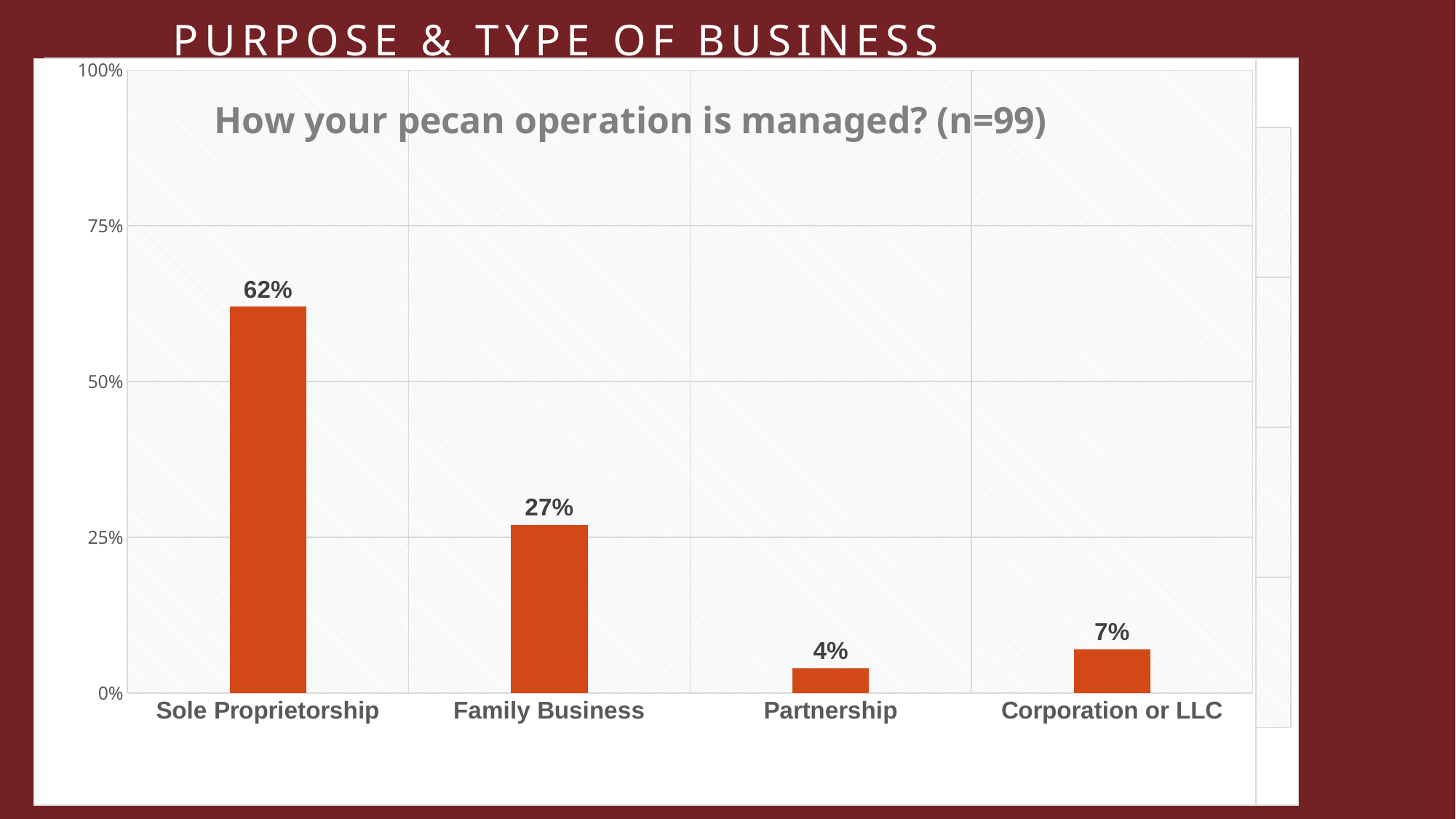
What kind of chart is shown on the slide? Bar chart How many management types are shown on the chart? 4 Which is larger, the value for Corporation or LLC or the value for Partnership? Corporation or LLC Which management type has the highest percentage? Sole Proprietorship What is the value shown for Partnership? 4% Is the value for Sole Proprietorship greater or less than 50%? greater What is the value shown for Family Business? 27% What is the value shown for Corporation or LLC? 7% What is the difference between the Sole Proprietorship and Family Business percentages? 35% Which management type has the lowest percentage? Partnership What is the title of the chart? How your pecan operation is managed? (n=99) What percentage of pecan operations are managed as a Sole Proprietorship? 62%